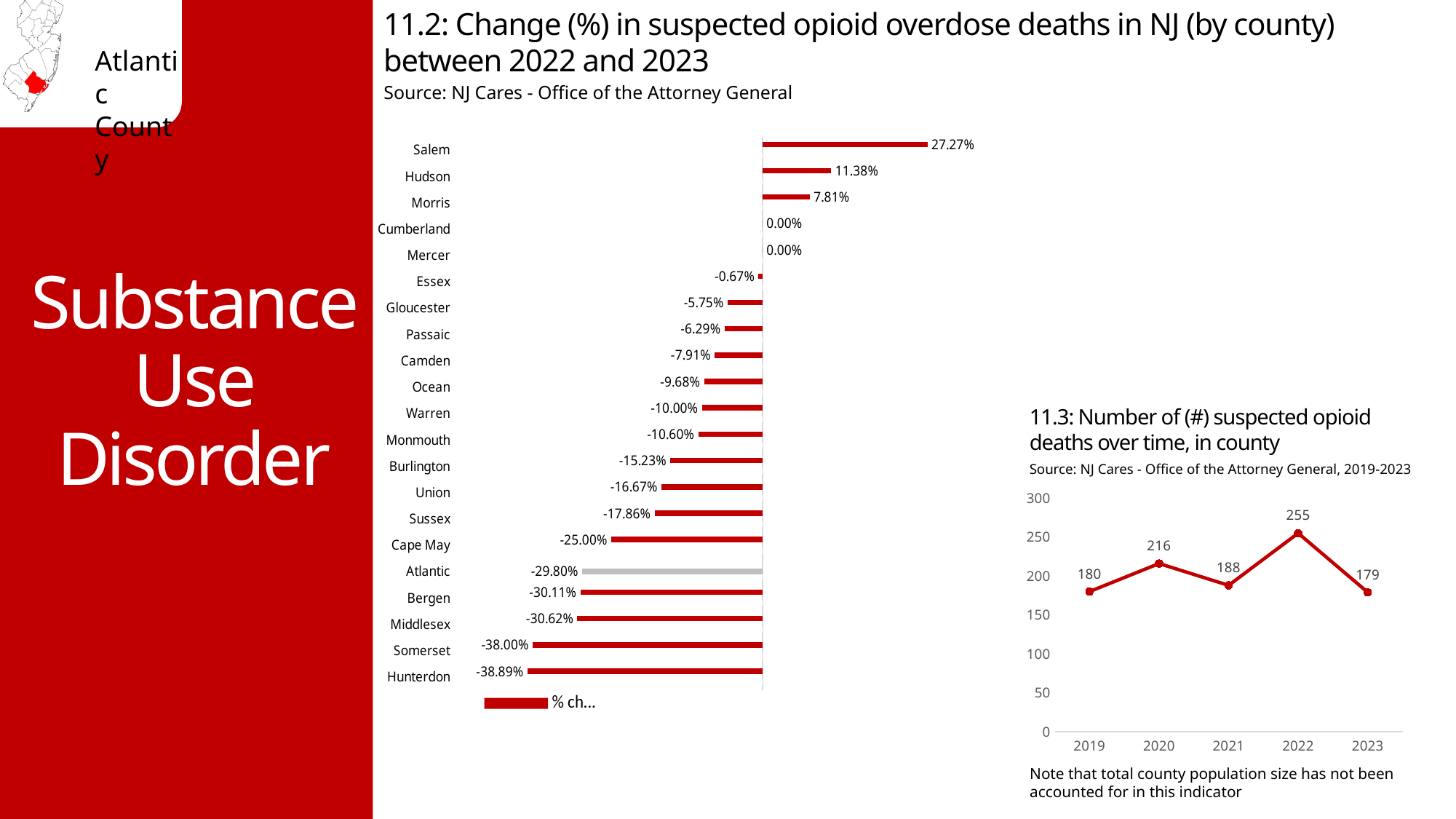
In the chart '11.2: Change (%) in suspected opioid overdose deaths in NJ (by county) between 2022 and 2023', how many counties are shown? 21 What kind of chart is '11.3: Number of (#) suspected opioid deaths over time, in county'? Line chart In the chart '11.3: Number of (#) suspected opioid deaths over time, in county', which year has the lowest value? 2023 In the chart '11.2: Change (%) in suspected opioid overdose deaths in NJ (by county) between 2022 and 2023', which is larger, the value for Bergen or the value for Middlesex? Bergen In the chart '11.3: Number of (#) suspected opioid deaths over time, in county', what is the difference between the 2022 value and the 2023 value? 76 In the chart '11.3: Number of (#) suspected opioid deaths over time, in county', how many years are plotted? 5 What kind of chart is '11.2: Change (%) in suspected opioid overdose deaths in NJ (by county) between 2022 and 2023'? Bar chart In the chart '11.3: Number of (#) suspected opioid deaths over time, in county', what is the value for 2022? 255 In the chart '11.2: Change (%) in suspected opioid overdose deaths in NJ (by county) between 2022 and 2023', what is the value for Hudson? 11.38% In the chart '11.2: Change (%) in suspected opioid overdose deaths in NJ (by county) between 2022 and 2023', which county has the lowest value? Hunterdon In the chart '11.2: Change (%) in suspected opioid overdose deaths in NJ (by county) between 2022 and 2023', which county has the highest value? Salem In the chart '11.2: Change (%) in suspected opioid overdose deaths in NJ (by county) between 2022 and 2023', what is the value for Atlantic? -29.80%